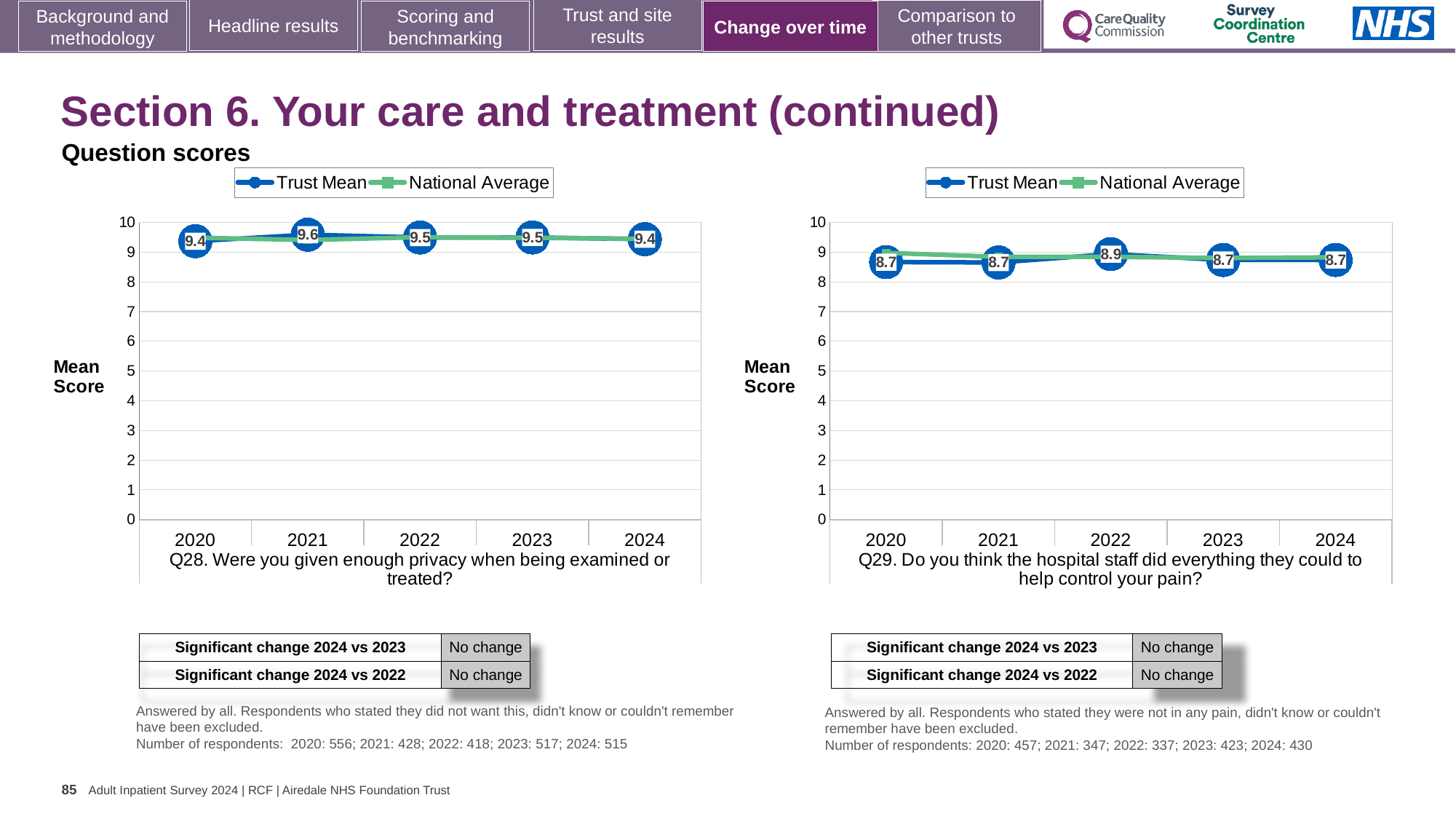
In the Q28 chart (left), what is the difference between the Trust Mean scores for 2021 and 2024? 0.2 How many years are plotted on the x axis of the Q28 chart (left)? 5 In the Q28 chart (left), what is the Trust Mean score for 2024? 9.4 How many series does the legend of the Q29 chart (right) list? 2 In the Q29 chart (right), which year has the highest Trust Mean score? 2022 In the Q29 chart (right), what is the Trust Mean score for 2022? 8.9 Which is larger: the 2022 Trust Mean score in the Q28 chart (left) or the 2022 Trust Mean score in the Q29 chart (right)? Q28 chart (left) In the Q28 chart (left), which year has the highest Trust Mean score? 2021 In the Q29 chart (right), what is the difference between the Trust Mean scores for 2022 and 2023? 0.2 In the Q29 chart (right), is the National Average value for 2020 greater or less than 8? greater In the Q29 chart (right), what is the Trust Mean score for 2020? 8.7 In the Q28 chart (left), what is the Trust Mean score for 2021? 9.6